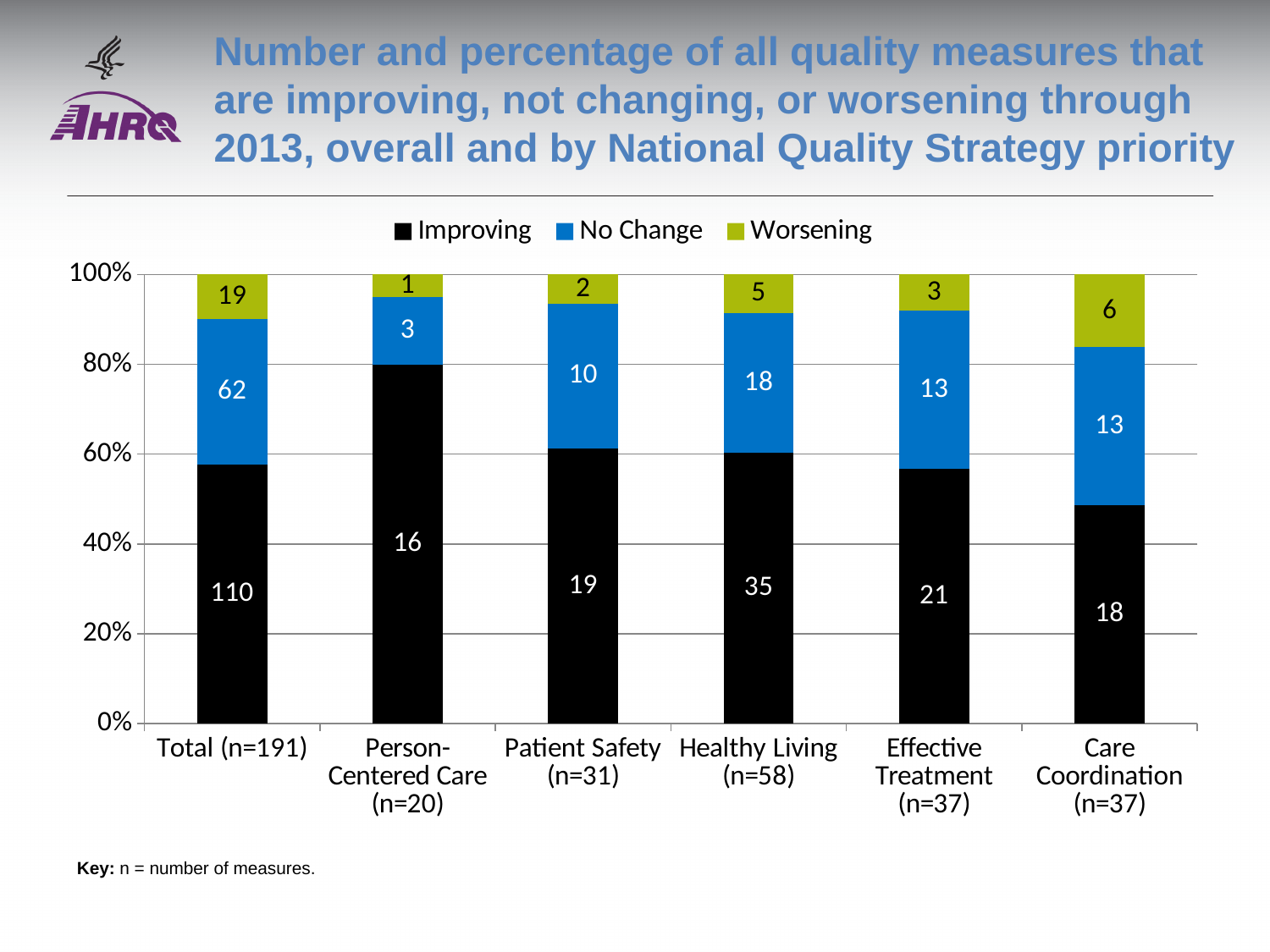
What is the total number of measures in the Patient Safety bar (sum of Improving, No Change and Worsening)? 31 Which has more Worsening measures, Healthy Living or Effective Treatment? Healthy Living Is the Improving segment for Care Coordination greater or less than 60% of its bar? less How many categories are shown along the x axis? 6 What is the difference between the number of Improving measures for Healthy Living and for Effective Treatment? 14 What type of chart is shown on the slide? Stacked bar chart Which category has the lowest number of Worsening measures? Person-Centered Care How many Care Coordination measures are Worsening? 6 How many Healthy Living measures show No Change? 18 Excluding the Total bar, which priority has the highest number of Improving measures? Healthy Living How many measures are Improving in the Total (n=191) bar? 110 How many series does the legend list? 3